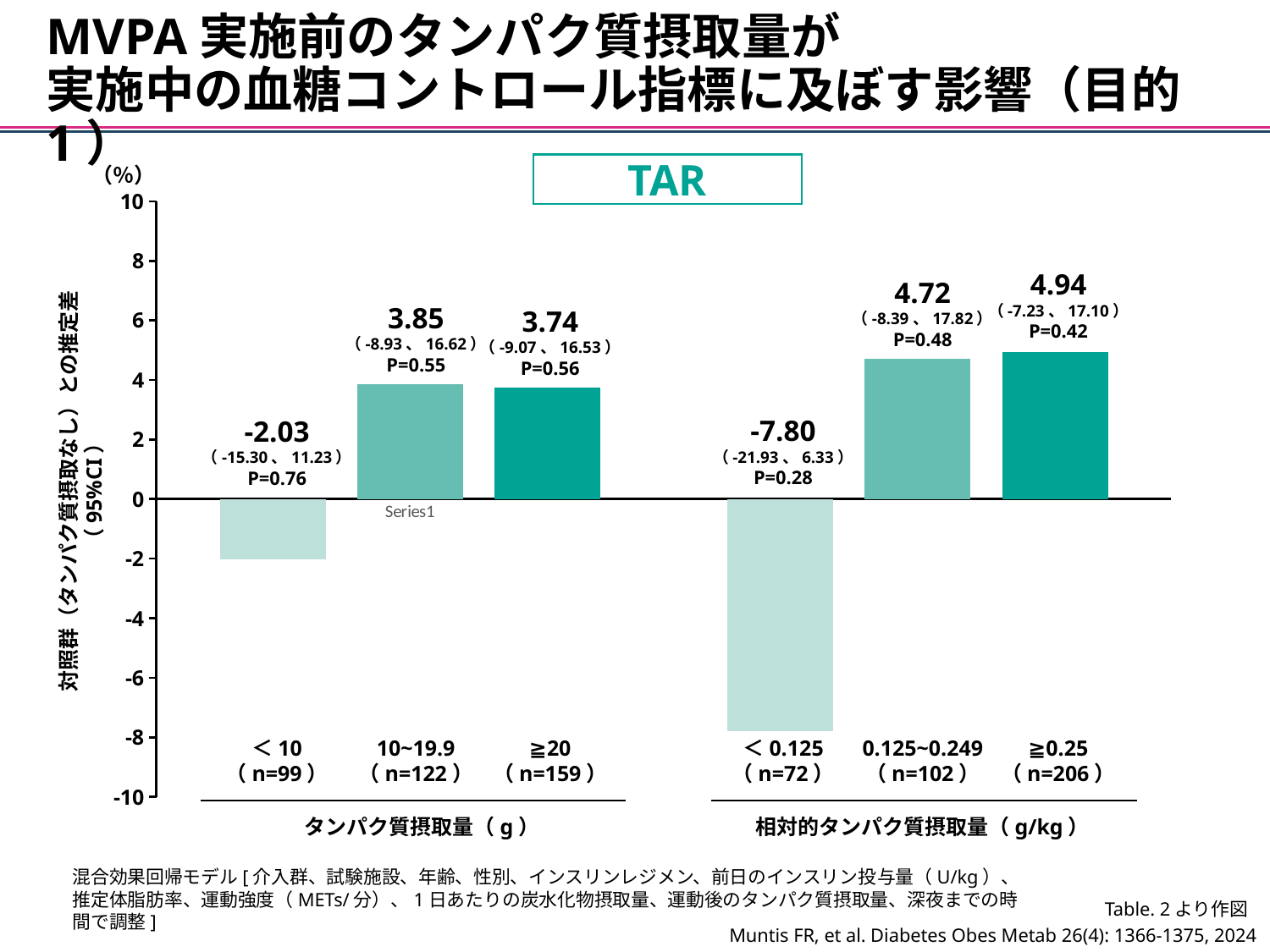
What is the value for the ≧0.25 g/kg relative protein intake group (n=206)? 4.94 Which category has the lowest value? < 0.125 (n=72) Is the value for the <0.125 g/kg group greater or less than -6? less What is the P value shown for the <0.125 g/kg group? P=0.28 What is the difference between the values for the 0.125~0.249 g/kg group and the ≧0.25 g/kg group? 0.22 What kind of chart is shown on the slide? bar chart What is the value for the <10 g protein intake group (n=99)? -2.03 Which category has the highest value? ≧0.25 (n=206) Which is larger, the value for the <10 g group or the value for the <0.125 g/kg group? <10 g group What is the value for the 10~19.9 g protein intake group (n=122)? 3.85 What is the title shown in the box above the chart? TAR How many bars are plotted in the chart? 6